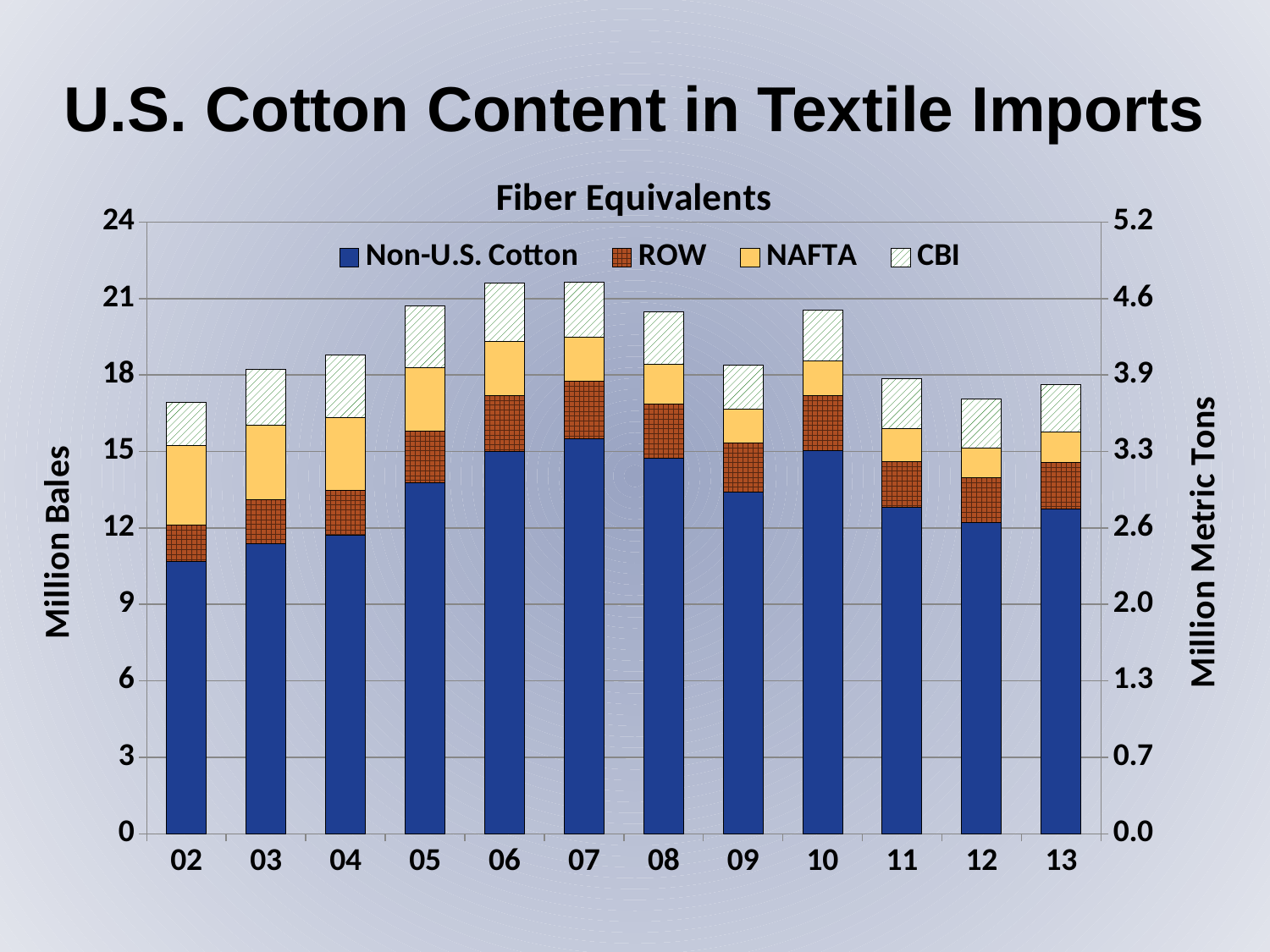
Is the total height of the bar for 06 greater or less than 21 million bales? greater What is the label of the left vertical axis? Million Bales How many years are shown on the x axis of the chart? 12 How many series does the chart's legend list? 4 Which series are listed in the chart's legend? Non-U.S. Cotton, ROW, NAFTA, CBI What kind of chart is shown on the slide? Stacked bar chart Is the total height of the bar for 02 greater or less than 18 million bales? less Do the total bar heights rise or fall from 02 to 07? rise Is the total height of the bar for 05 greater or less than 18 million bales? greater Which year has the larger Non-U.S. Cotton segment, 07 or 02? 07 Which year has the taller total bar, 05 or 03? 05